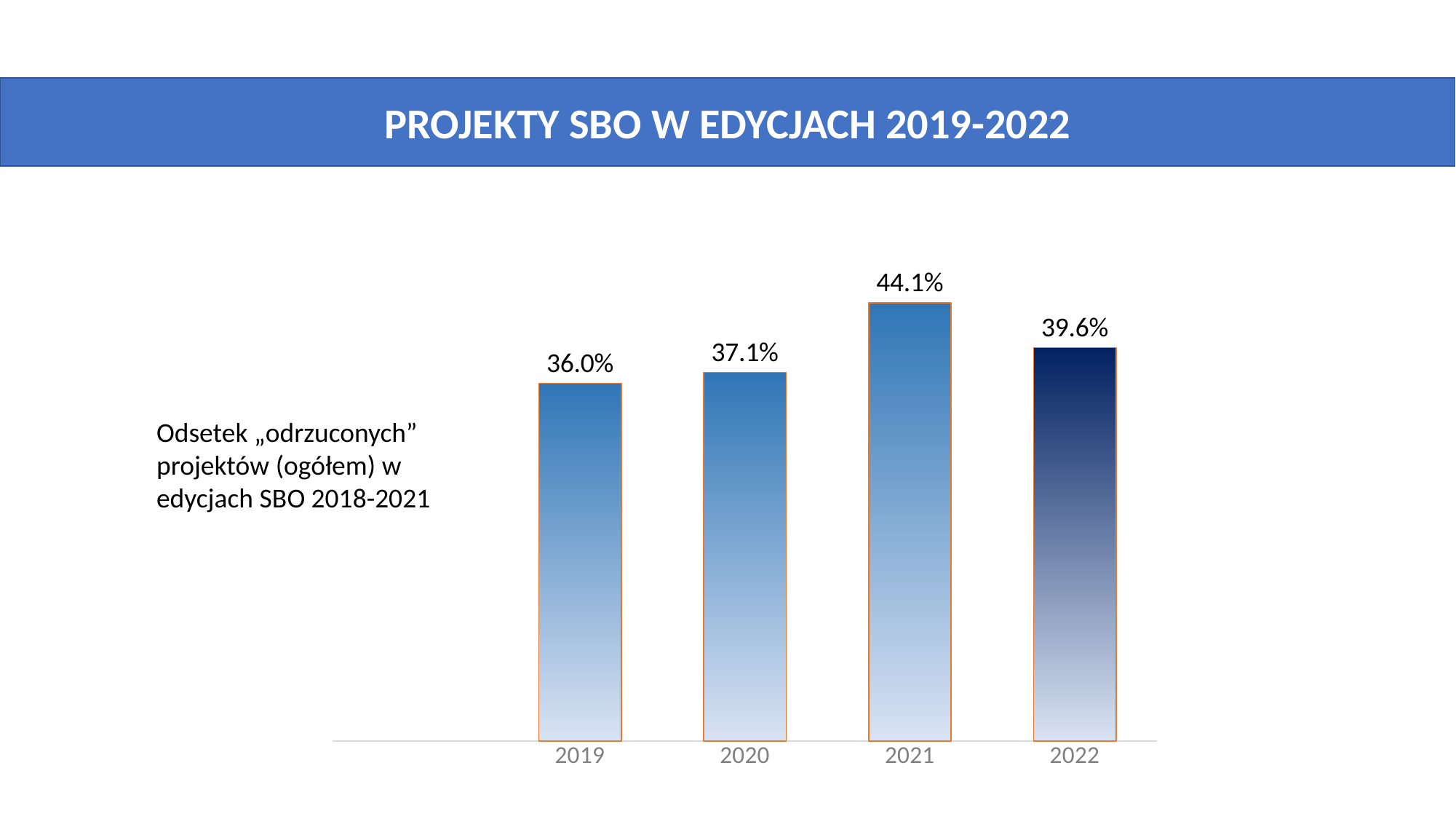
How many years are shown on the x axis? 4 Which is larger, the value for 2022 or the value for 2020? 2022 What is the value shown for 2019? 36.0% What is the value shown for 2021? 44.1% What is the title shown in the banner at the top of the slide? PROJEKTY SBO W EDYCJACH 2019-2022 What is the value shown for 2020? 37.1% Which year has the highest value? 2021 Which year has the lowest value? 2019 What kind of chart is shown on the slide? bar chart What is the value shown for 2022? 39.6% What is the difference between the values for 2021 and 2019? 8.1% What is the difference between the values for 2021 and 2022? 4.5%